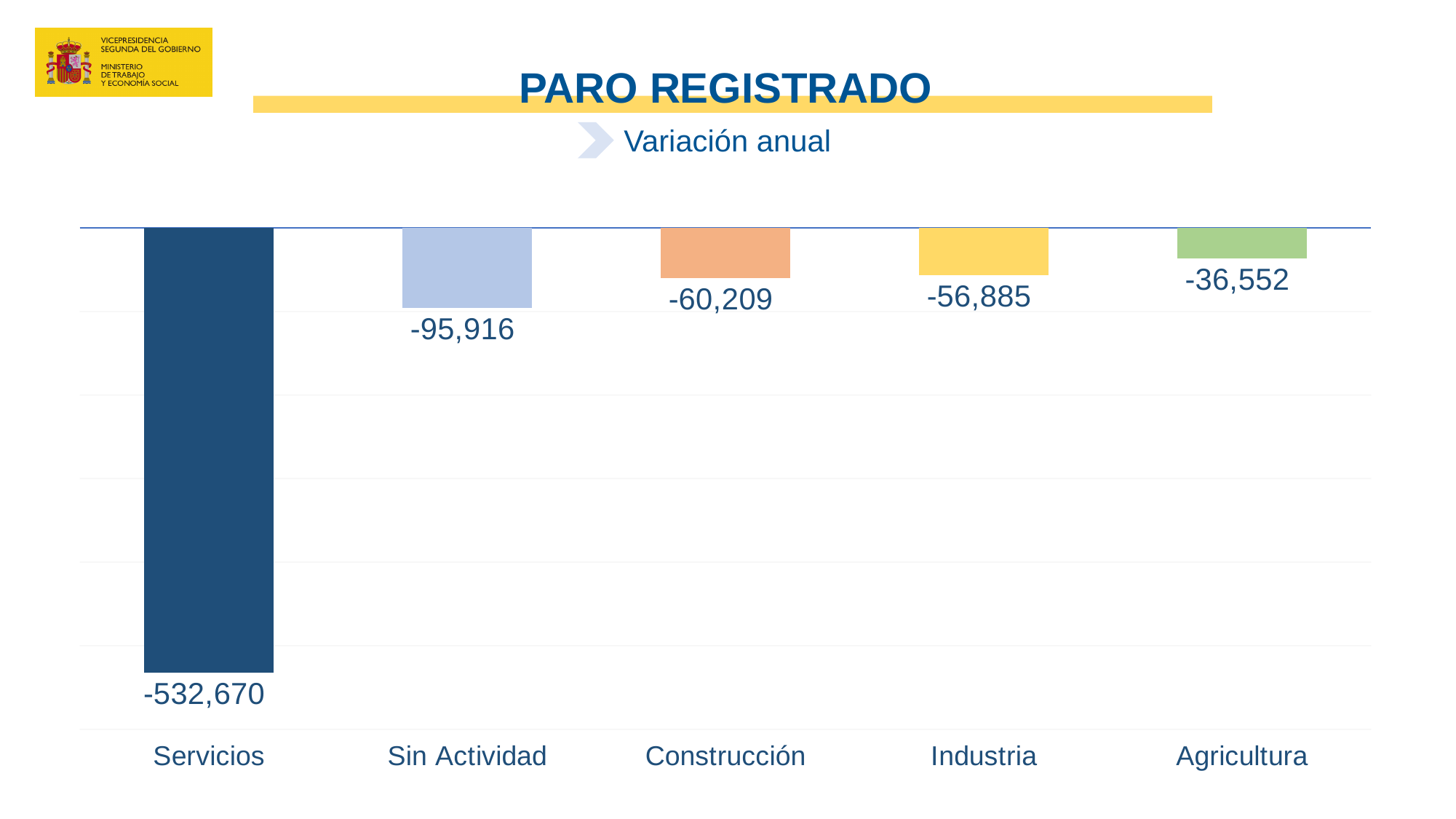
What is the title of the chart on the slide? PARO REGISTRADO Which category has the lowest (most negative) value? Servicios What is the value shown for Industria? -56,885 What kind of chart is shown on the slide? Bar chart By how much does the value for Sin Actividad differ from the value for Construcción? 35,707 What is the value shown for Servicios? -532,670 Which category has the highest (least negative) value? Agricultura How many categories are shown in the chart? 5 What is the value shown for Construcción? -60,209 What is the value shown for Agricultura? -36,552 What is the value shown for Sin Actividad? -95,916 Which has the larger decrease, Servicios or Sin Actividad? Servicios